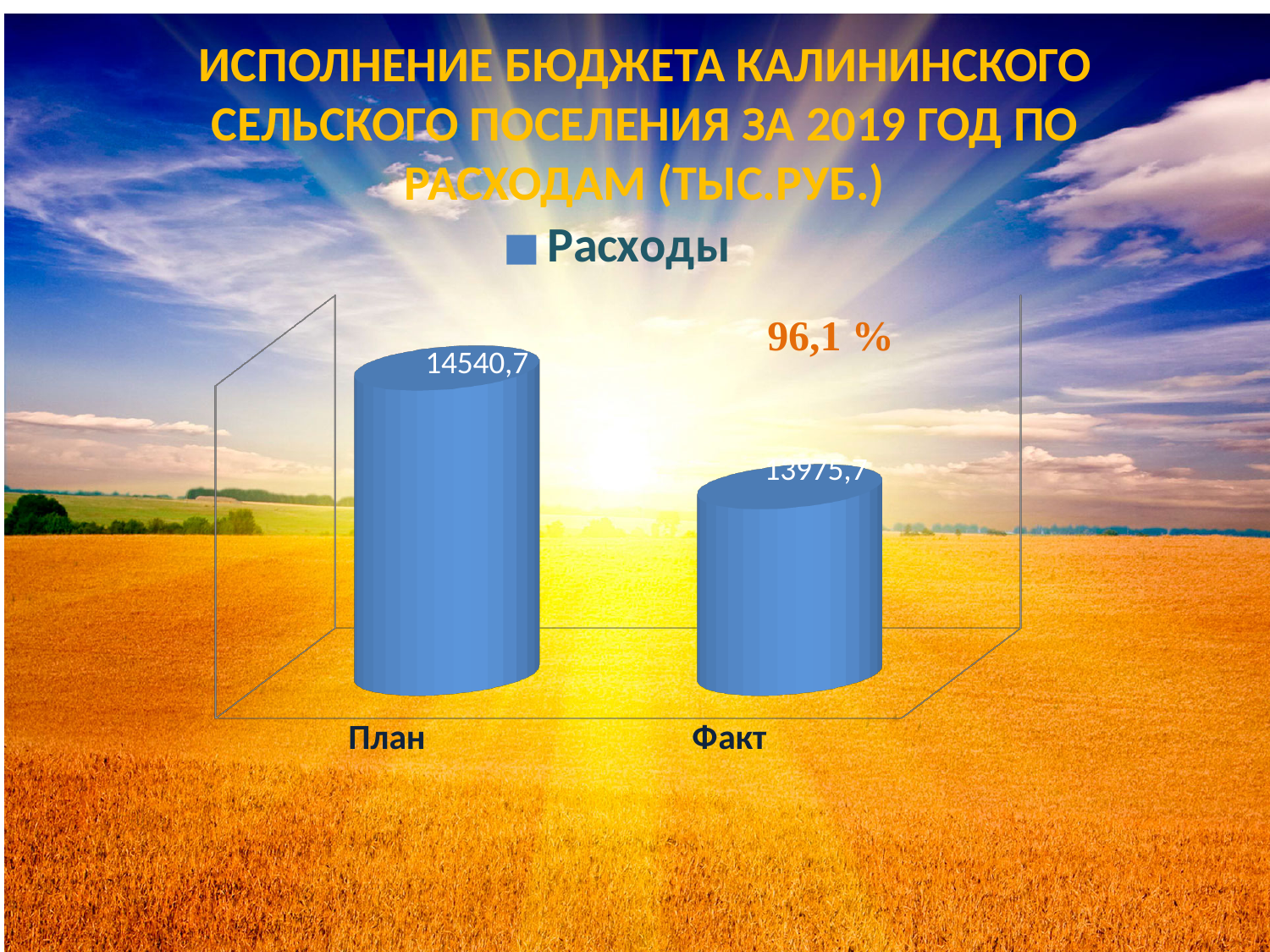
What is the difference between the values for План and Факт? 565,0 Which category has the higher value, План or Факт? План Is the value for Факт larger or smaller than the value for План? smaller How many series does the legend list? 1 Which category has the lowest value? Факт What percentage is printed above the Факт bar? 96,1 % How many categories are shown on the x axis? 2 What kind of chart is shown on the slide? bar chart What is the value for Факт? 13975,7 What is the name of the series in the legend? Расходы What is the value for План? 14540,7 Do the values rise or fall from План to Факт? fall